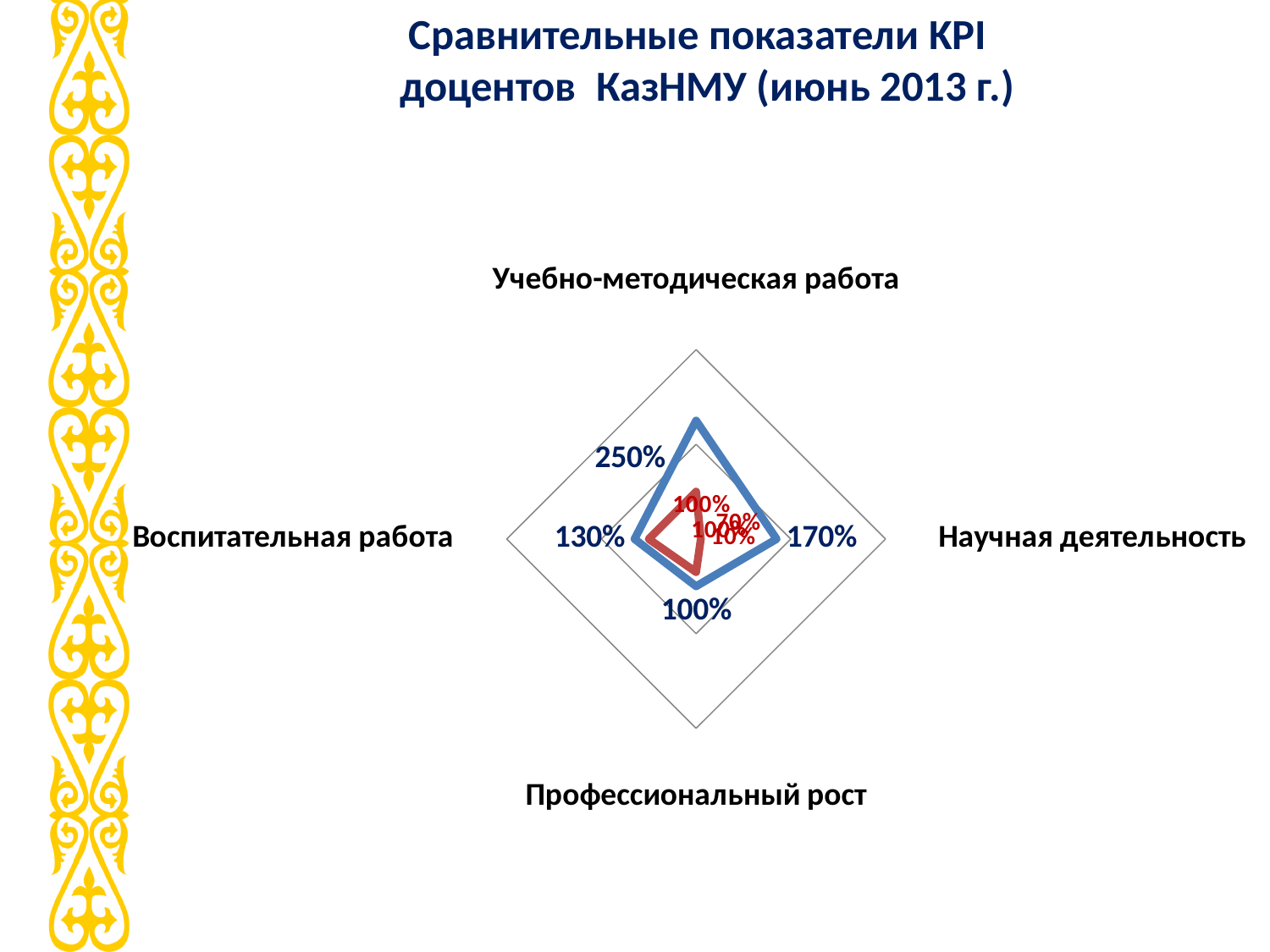
How many categories (axes) does the radar chart have? 4 For the blue series, which category has the highest value? Учебно-методическая работа For the blue series, which is larger: the value for Научная деятельность or for Воспитательная работа? Научная деятельность For the blue series, what is the difference between the values for Учебно-методическая работа and Научная деятельность? 80 percentage points What is the value of the blue series for Воспитательная работа? 130% What is the value of the blue series for Профессиональный рост? 100% What is the value of the blue series for Научная деятельность? 170% What is the value of the blue series for Учебно-методическая работа? 250% What is the title of the slide containing the chart? Сравнительные показатели KPI доцентов КазНМУ (июнь 2013 г.) For the blue series, which category has the lowest value? Профессиональный рост What kind of chart is shown on the slide? Radar chart On the Учебно-методическая работа axis, which series has the larger value: the blue one or the red one? The blue one